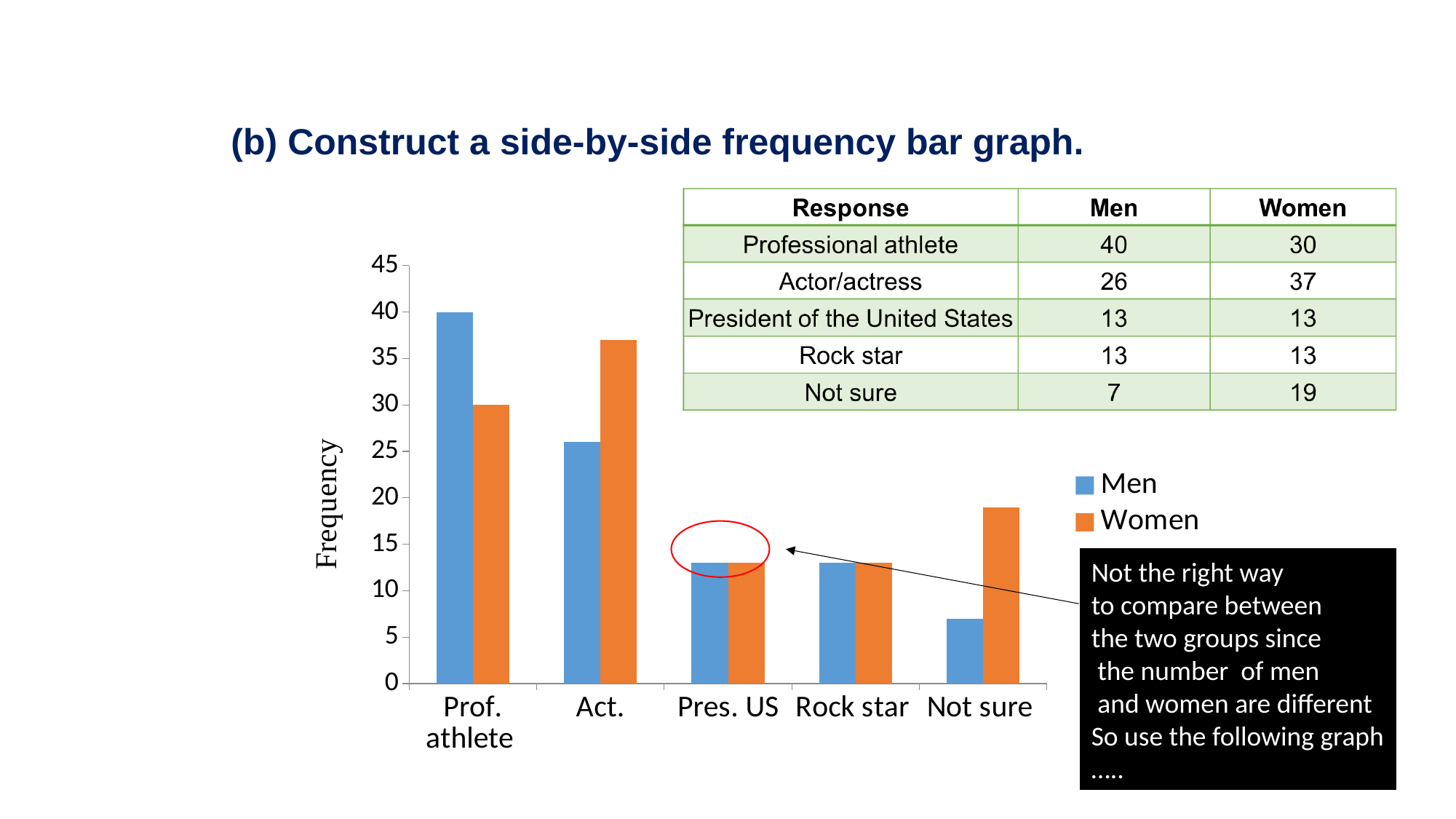
What is the frequency for Women for Act.? 37 What is the label of the y axis of the chart? Frequency What kind of chart is shown on the slide? bar chart How many series does the chart legend list? 2 Which category has the highest frequency for Men? Prof. athlete What is the frequency for Women for Not sure? 19 How many response categories are shown on the x axis of the chart? 5 For Not sure, which is larger, the Men frequency or the Women frequency? Women What is the difference between the Men and Women frequencies for Prof. athlete? 10 Is the Men frequency for Act. greater or less than 30? less Which category has the lowest frequency for Men? Not sure What is the frequency for Men for Prof. athlete? 40